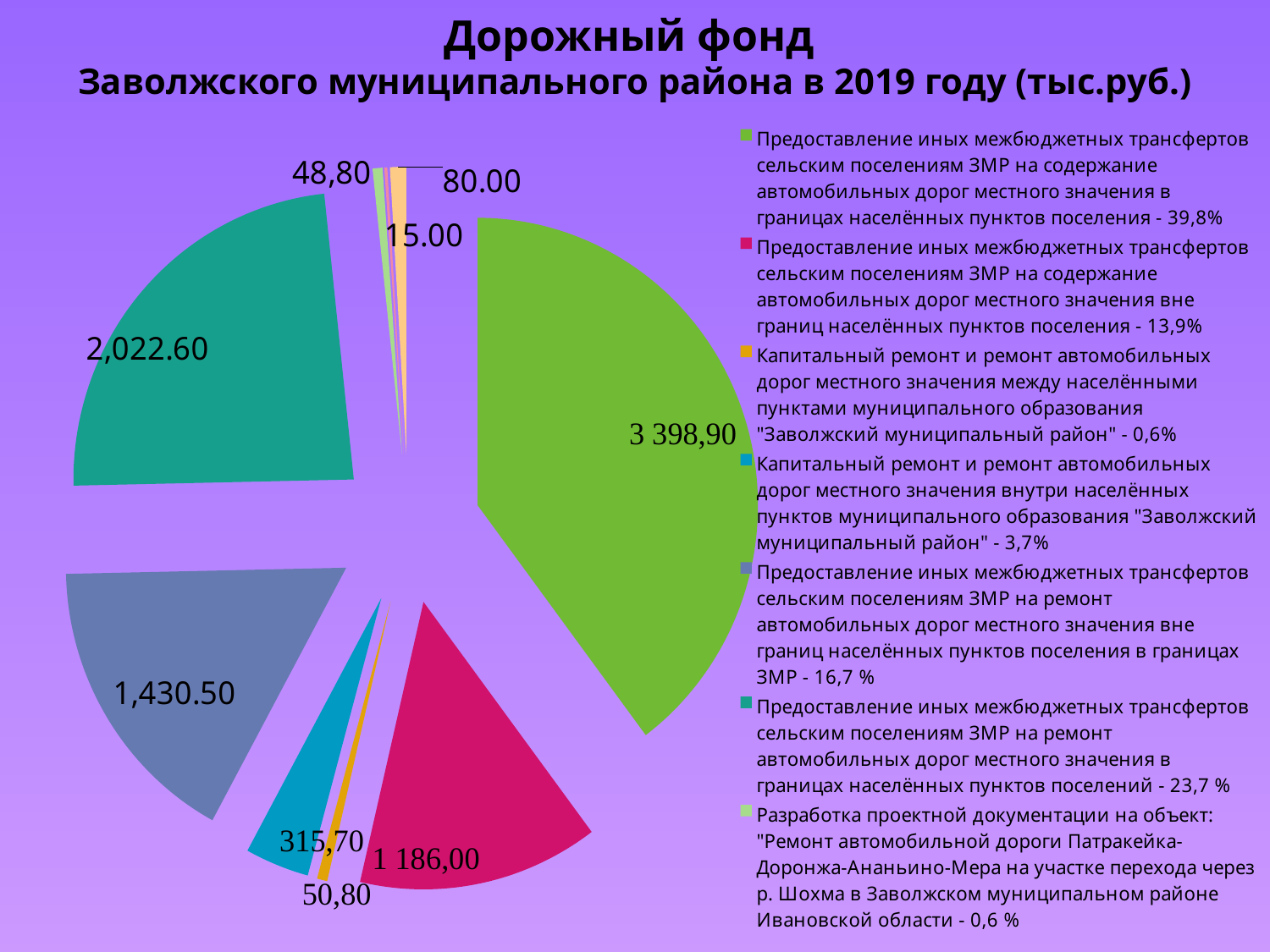
What value is shown on the teal slice (the legend entry ending in 23,7 %)? 2,022.60 What value is shown on the grey-blue slice (the legend entry ending in 16,7 %)? 1,430.50 According to the legend, what share of the fund goes to transfers for maintaining roads within settlement boundaries (the green slice)? 39,8% What value is shown on the orange slice for capital repair of roads between settlements? 50,80 What is the title of the chart? Дорожный фонд Заволжского муниципального района в 2019 году (тыс.руб.) What value is shown on the blue slice for capital repair of roads inside settlements (3,7%)? 315,70 What colour is the largest slice of the pie? green What is the value of the largest slice of the pie? 3 398,90 What kind of chart is shown on the slide? pie chart Which is larger: the grey-blue slice (1,430.50) or the red slice (1 186,00)? 1,430.50 What value is shown on the red slice (the legend entry ending in 13,9%)? 1 186,00 How many entries does the legend list? 7